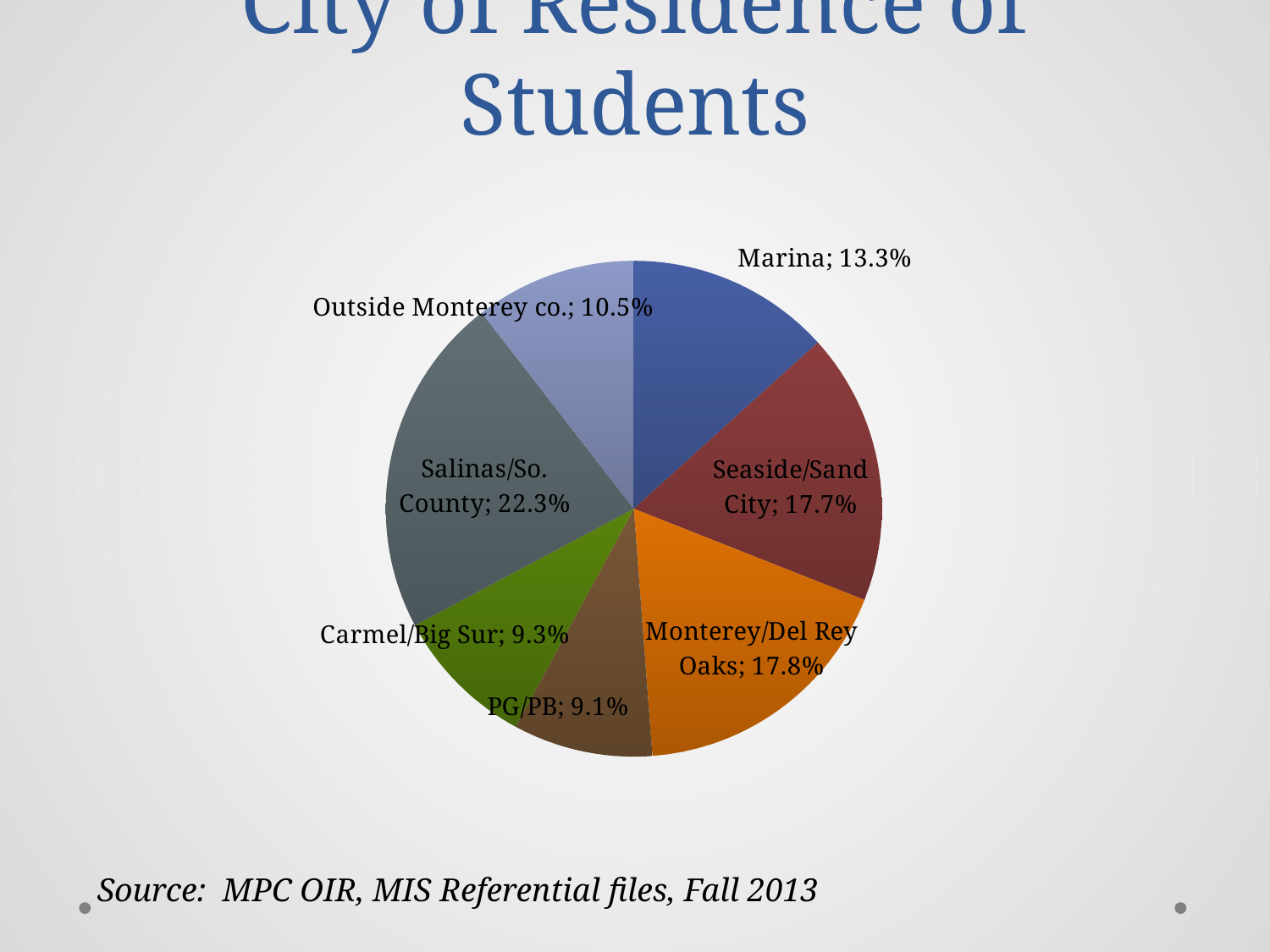
How many slices does the pie chart have? 7 Which is larger, the share for Salinas/So. County or the share for Outside Monterey co.? Salinas/So. County Which city of residence has the largest share of students? Salinas/So. County What percentage of students live Outside Monterey co.? 10.5% What kind of chart is shown on the slide? Pie chart What is the difference between the Salinas/So. County share and the Marina share? 9.0% What percentage of students live in Salinas/So. County? 22.3% What percentage of students live in PG/PB? 9.1% What is the difference between the Seaside/Sand City share and the Carmel/Big Sur share? 8.4% What percentage of students live in Seaside/Sand City? 17.7% What percentage of students live in Marina? 13.3% Which is larger, the share for Marina or the share for Carmel/Big Sur? Marina